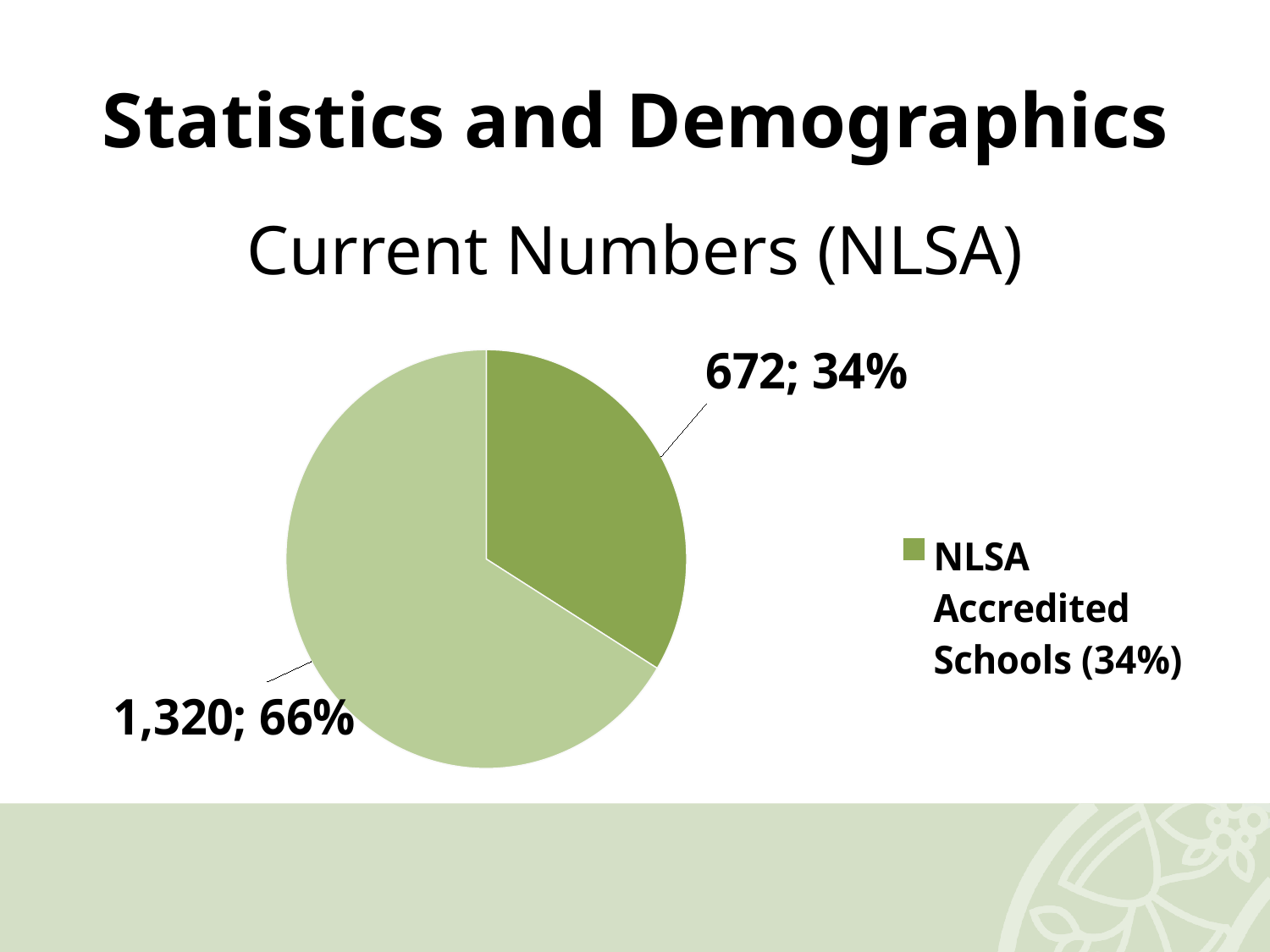
What is the title of the chart? Current Numbers (NLSA) What is the difference between the larger slice value and the NLSA Accredited Schools value? 648 What is the value shown on the larger slice of the pie? 1,320 How many slices does the pie chart have? 2 What share of the pie do NLSA Accredited Schools represent? 34% What is the value shown for NLSA Accredited Schools? 672 Which slice is the largest in the pie chart? 1,320; 66% Is the NLSA Accredited Schools slice larger or smaller than the other slice? smaller What kind of chart is shown on the slide? pie chart What legend entry is shown next to the pie chart? NLSA Accredited Schools (34%) What is the total of the two slice values in the pie chart? 1,992 What percentage is shown on the larger slice of the pie? 66%